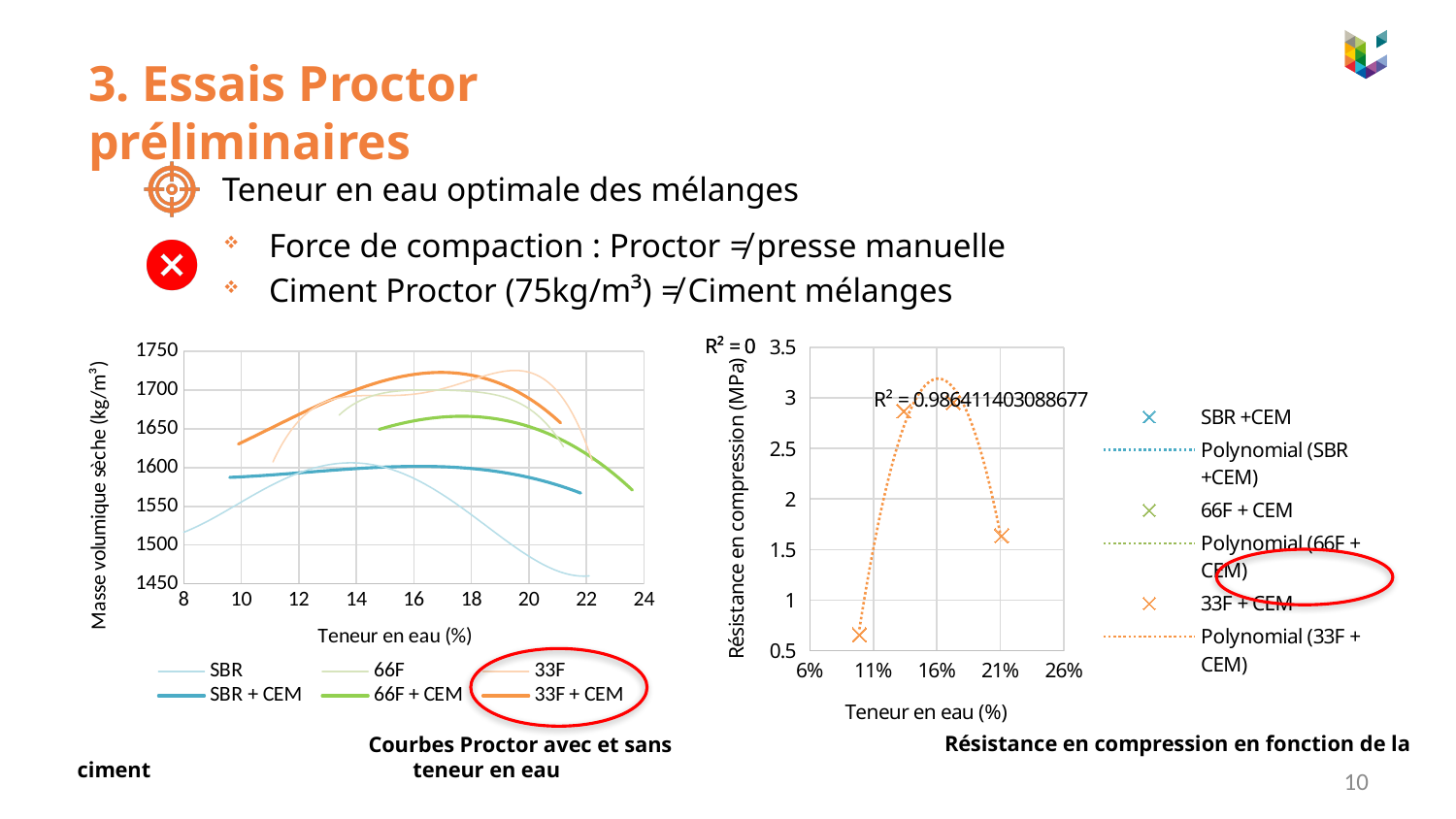
In the left chart (Courbes Proctor), is the SBR + CEM curve greater or less than 1650 across its range? less How many series does the legend of the left chart (Courbes Proctor) list? 6 What R² value is printed on the right chart (Résistance en compression)? 0.986411403088677 In the right chart (Résistance en compression), is the value of the point at about 21% water content greater or less than 2 MPa? less How many data points are plotted on the right chart (Résistance en compression)? 4 In the left chart (Courbes Proctor), which series is circled in red in the legend? 33F and 33F + CEM What kind of chart is the right chart, 'Résistance en compression en fonction de la teneur en eau'? scatter chart What is the y-axis label of the left chart (Courbes Proctor)? Masse volumique sèche (kg/m³) In the left chart (Courbes Proctor), which curve reaches a higher dry density: 33F + CEM or SBR + CEM? 33F + CEM In the left chart (Courbes Proctor), is the peak value of the 33F + CEM curve greater or less than 1700? greater What kind of chart is the left chart, 'Courbes Proctor avec et sans ciment'? line chart How many entries does the legend of the right chart (Résistance en compression) list? 6